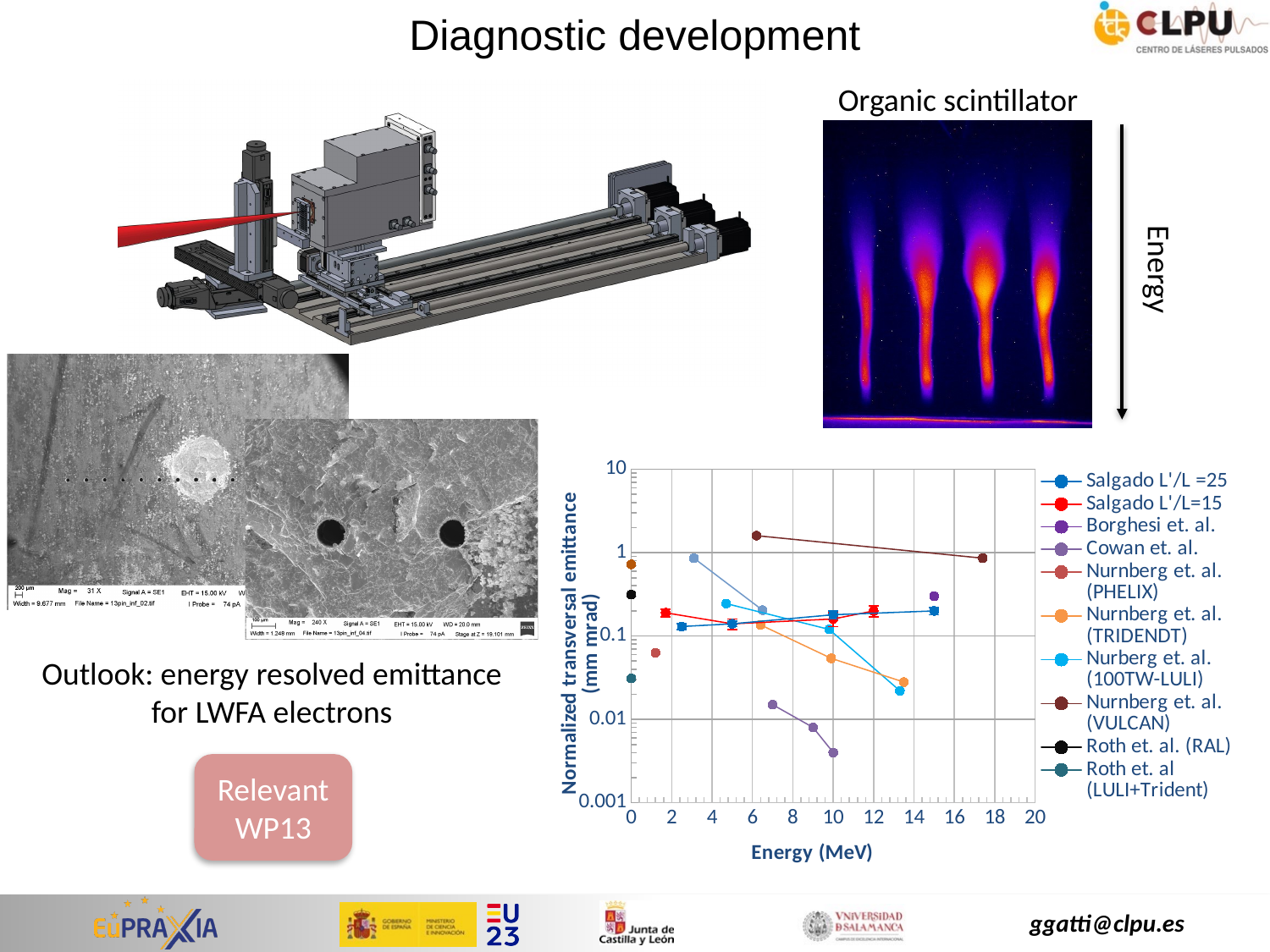
Is the value of the Roth et. al (LULI+Trident) series greater or less than 0.1? less Which series has the highest plotted emittance value on the chart? Nurnberg et. al. (VULCAN) Does the Nurberg et. al. (100TW-LULI) series rise or fall as energy increases? fall Is the lowest value of the Borghesi et. al. series greater or less than 0.01? greater What is the title of the x axis of the chart? Energy (MeV) Is the highest value of the Nurnberg et. al. (VULCAN) series greater or less than 1? greater What kind of chart is shown on the slide? Scatter/line chart How many series does the chart legend list? 10 Which series has the lowest plotted emittance value on the chart? Cowan et. al. What is the title of the y axis of the chart? Normalized transversal emittance (mm mrad)